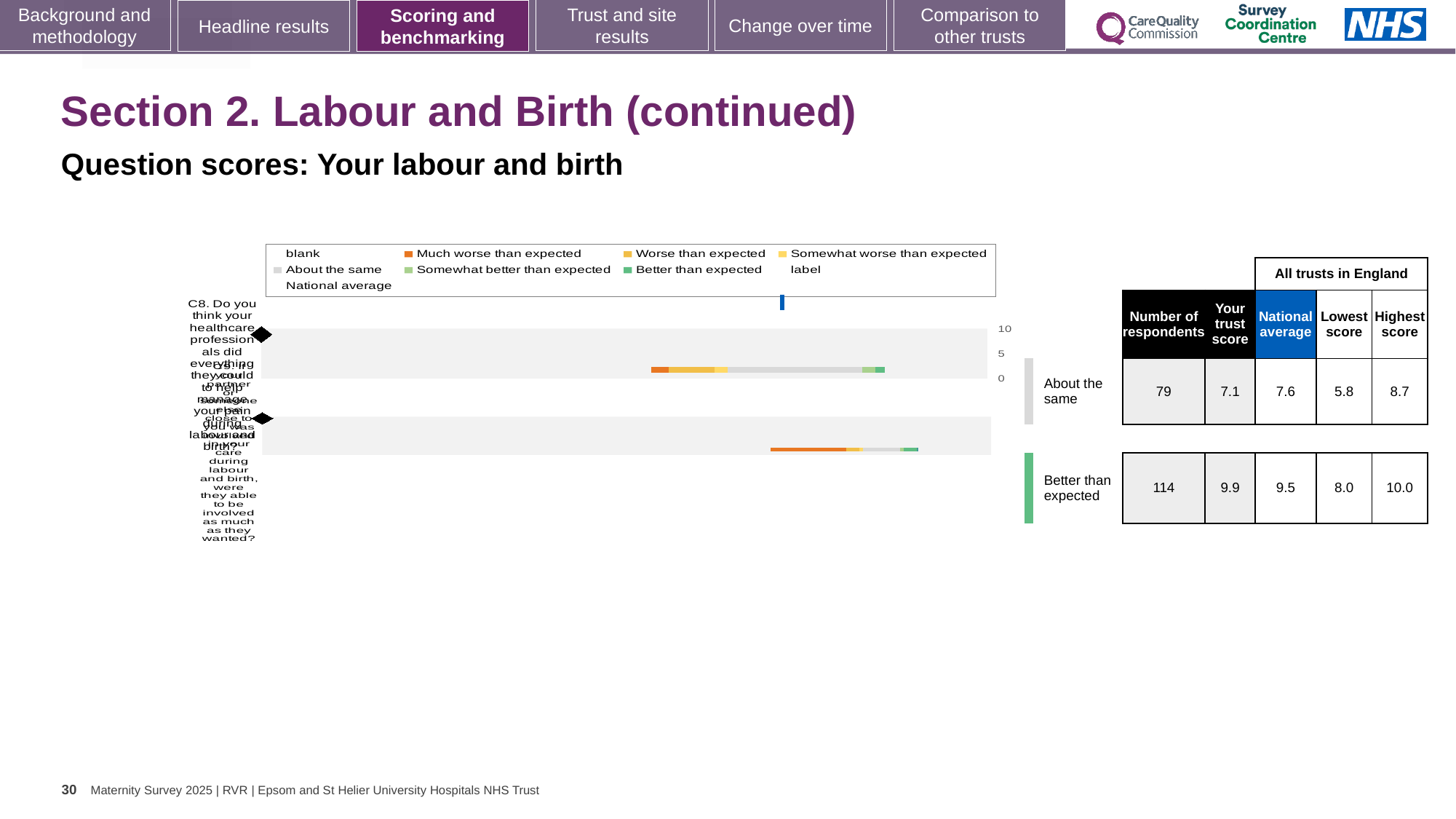
For the question rated 'Better than expected', what is the difference between the trust score and the national average? 0.4 What kind of chart is shown on the slide? bar chart How many question rows are plotted in the chart? 2 What is the highest value shown on the chart's numeric axis? 10 Which colour in the legend represents 'Much worse than expected'? orange What is the national average for the question rated 'Better than expected'? 9.5 What is the highest score across all trusts in England for the question rated 'Better than expected'? 10.0 What is the number of respondents for the question rated 'About the same'? 79 For the question rated 'About the same', what is the difference between the highest score and the lowest score across all trusts in England? 2.9 What is the trust score for the question rated 'About the same'? 7.1 For the question rated 'About the same', which is larger: the trust score or the national average? national average Is the trust score for the question rated 'About the same' greater or less than 5? greater